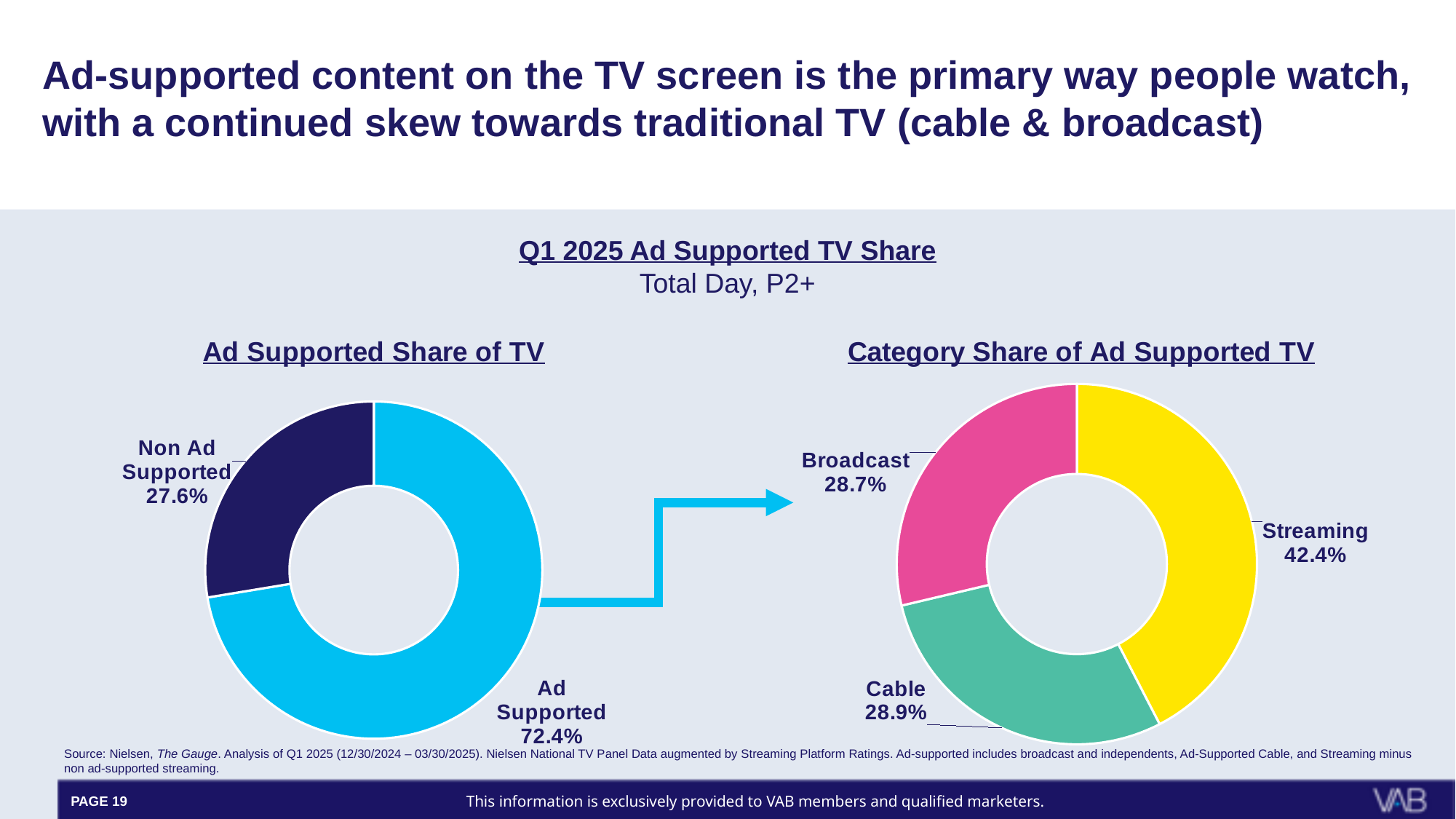
What type of chart is the 'Ad Supported Share of TV' chart? Doughnut chart In the 'Ad Supported Share of TV' chart, what is the difference in percentage points between Ad Supported and Non Ad Supported? 44.8 In the 'Ad Supported Share of TV' chart, what is the share for Ad Supported? 72.4% In the 'Category Share of Ad Supported TV' chart, what is the difference in percentage points between Streaming and Broadcast? 13.7 In the 'Ad Supported Share of TV' chart, which slice is larger, Ad Supported or Non Ad Supported? Ad Supported In the 'Category Share of Ad Supported TV' chart, what is the share for Broadcast? 28.7% In the 'Ad Supported Share of TV' chart, what is the share for Non Ad Supported? 27.6% In the 'Category Share of Ad Supported TV' chart, which category has the largest share? Streaming What is the overall title above the two charts on the slide? Q1 2025 Ad Supported TV Share How many categories are shown in the 'Category Share of Ad Supported TV' chart? 3 In the 'Category Share of Ad Supported TV' chart, what is the share for Streaming? 42.4% In the 'Category Share of Ad Supported TV' chart, what is the share for Cable? 28.9%